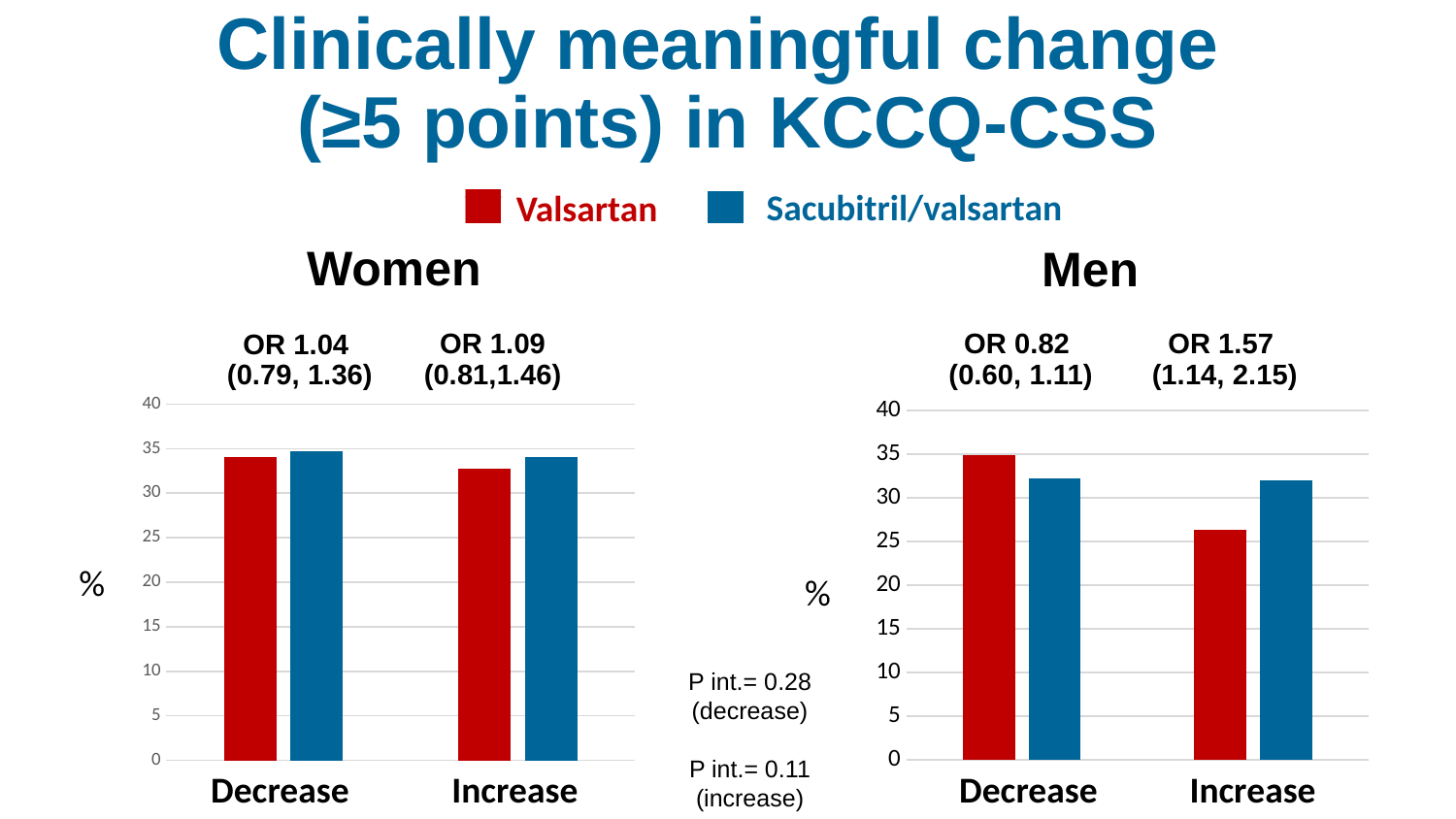
What kind of chart is the Women chart? bar chart In the Men chart, which bar is the lowest? Valsartan, Increase In the Men chart, for Increase, which is larger: Valsartan or Sacubitril/valsartan? Sacubitril/valsartan What odds ratio is printed above the Increase bars in the Men chart? OR 1.57 (1.14, 2.15) In the Men chart, for Decrease, which is larger: Valsartan or Sacubitril/valsartan? Valsartan In the Women chart, is the Valsartan value for Increase greater or less than 30? greater How many categories are shown on the x axis of the Men chart? 2 How many series does the legend list? 2 Which colour represents Sacubitril/valsartan in the legend? blue In the Men chart, which bar is the highest? Valsartan, Decrease In the Men chart, is the Valsartan value for Increase greater or less than 30? less In the Men chart, is the Valsartan value for Decrease greater or less than 30? greater